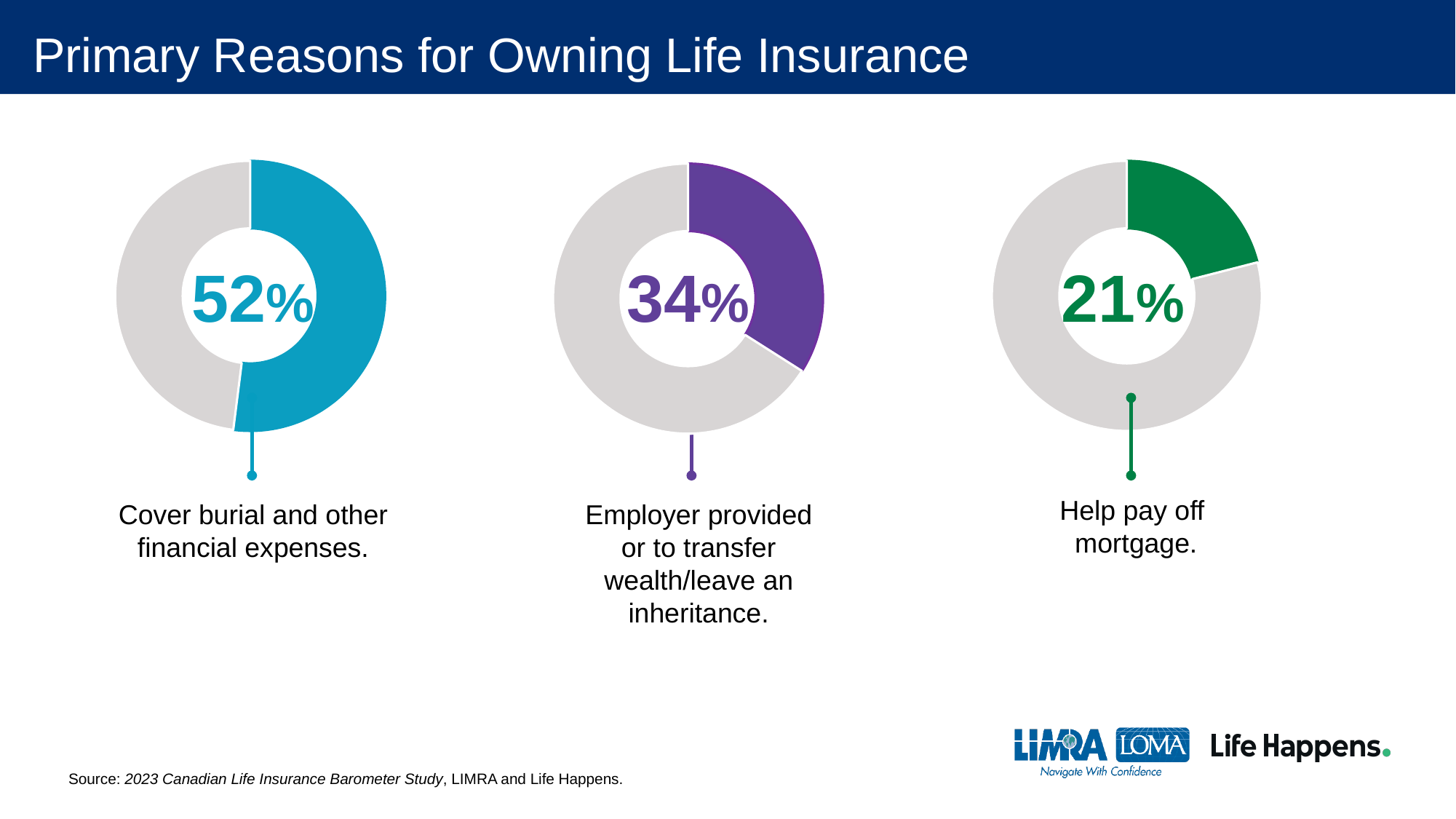
Which is larger: the percentage for employer provided/transfer wealth or the percentage for help pay off mortgage? Employer provided or to transfer wealth/leave an inheritance Which reason for owning life insurance has the lowest percentage on the slide? Help pay off mortgage What percentage of respondents own life insurance because it is employer provided or to transfer wealth/leave an inheritance? 34% What is the difference in percentage points between the employer provided/transfer wealth reason and the help pay off mortgage reason? 13 What is the difference in percentage points between covering burial and other financial expenses and helping pay off a mortgage? 31 How many donut charts are shown on the slide? 3 What colour is the filled portion of the donut chart for help pay off mortgage? Green What is the title of the slide? Primary Reasons for Owning Life Insurance What kind of chart is used to show each percentage on the slide? Donut chart What percentage of respondents own life insurance to cover burial and other financial expenses? 52% What percentage of respondents own life insurance to help pay off a mortgage? 21% Which reason for owning life insurance has the highest percentage on the slide? Cover burial and other financial expenses